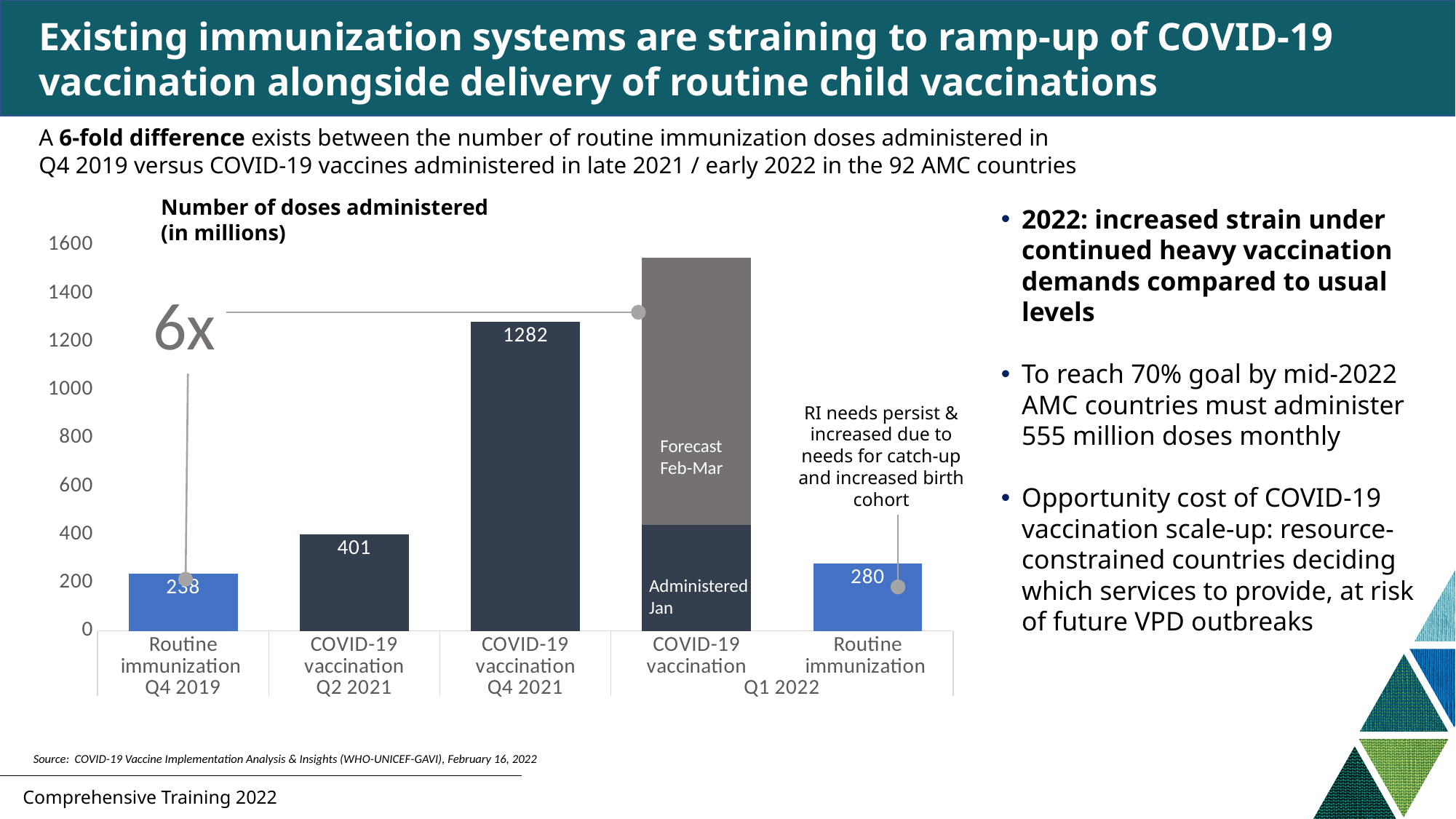
Is the value for Routine immunization Q4 2019 greater or less than 400? less What kind of chart is shown on the slide? bar chart Which category has the tallest bar? COVID-19 vaccination Q1 2022 What is the value for COVID-19 vaccination Q2 2021? 401 What is the value for Routine immunization Q1 2022? 280 What is the difference between COVID-19 vaccination Q2 2021 and Routine immunization Q1 2022? 121 Is the top of the COVID-19 vaccination Q1 2022 bar (including the Forecast Feb-Mar segment) greater or less than 1400? greater What is the title of the chart? Number of doses administered (in millions) Which is larger: COVID-19 vaccination Q2 2021 or Routine immunization Q1 2022? COVID-19 vaccination Q2 2021 How many categories are shown on the x axis? 5 What is the difference between COVID-19 vaccination Q4 2021 and COVID-19 vaccination Q2 2021? 881 What is the value for COVID-19 vaccination Q4 2021? 1282